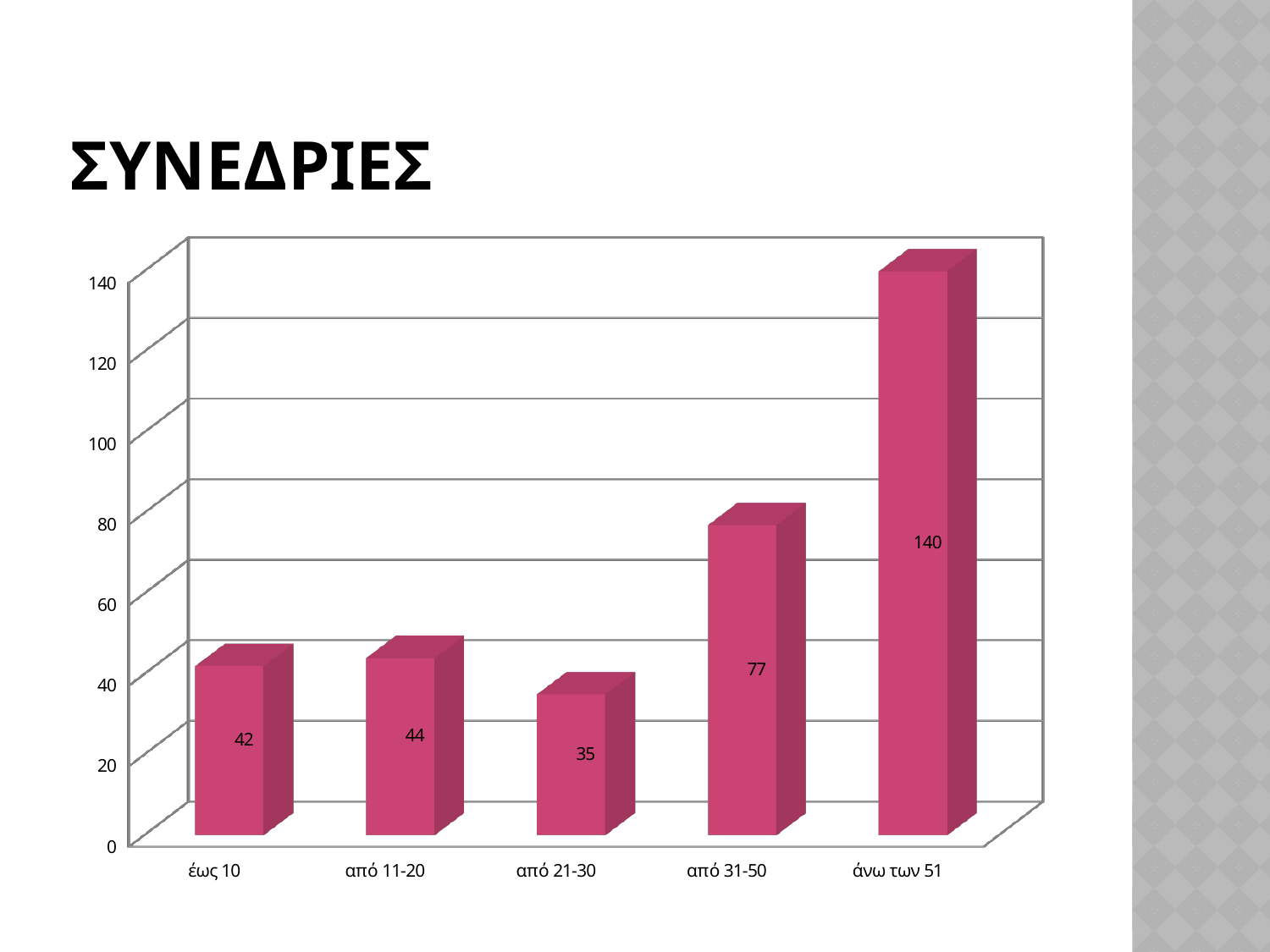
What is the difference between the values for 'άνω των 51' and 'από 31-50'? 63 What is the value for 'άνω των 51'? 140 What is the difference between the values for 'από 11-20' and 'από 21-30'? 9 Which is larger, the value for 'από 11-20' or the value for 'έως 10'? από 11-20 What is the value for 'από 31-50'? 77 Which category has the lowest value? από 21-30 What kind of chart is shown on the slide? bar chart Which category has the highest value? άνω των 51 How many categories are shown on the x axis? 5 What is the value for 'έως 10'? 42 Is the value for 'από 31-50' greater or less than 60? greater What is the title of the slide? ΣΥΝΕΔΡΙΕΣ